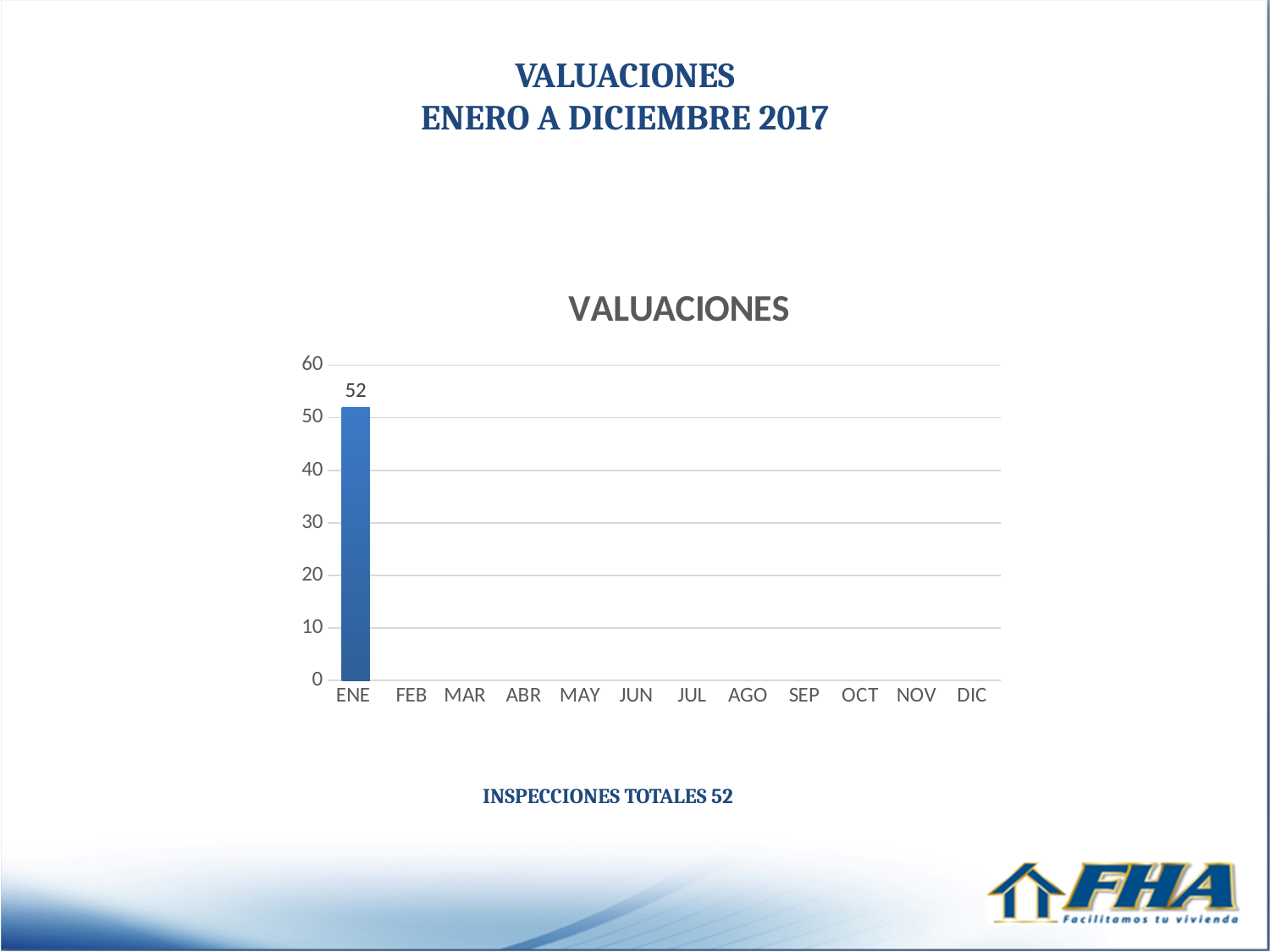
Which month has the highest value in the VALUACIONES chart? ENE What is the last month label on the x axis of the VALUACIONES chart? DIC What is the title of the chart? VALUACIONES How many months in the VALUACIONES chart have a visible bar? 1 Is the value for ENE greater or less than 50? greater What is the value for ENE in the VALUACIONES chart? 52 What is the first month label on the x axis of the VALUACIONES chart? ENE Is the value for ENE greater or less than 60? less How many months are shown on the x axis of the VALUACIONES chart? 12 What is the highest value shown on the y axis of the VALUACIONES chart? 60 What kind of chart is the VALUACIONES chart? bar chart